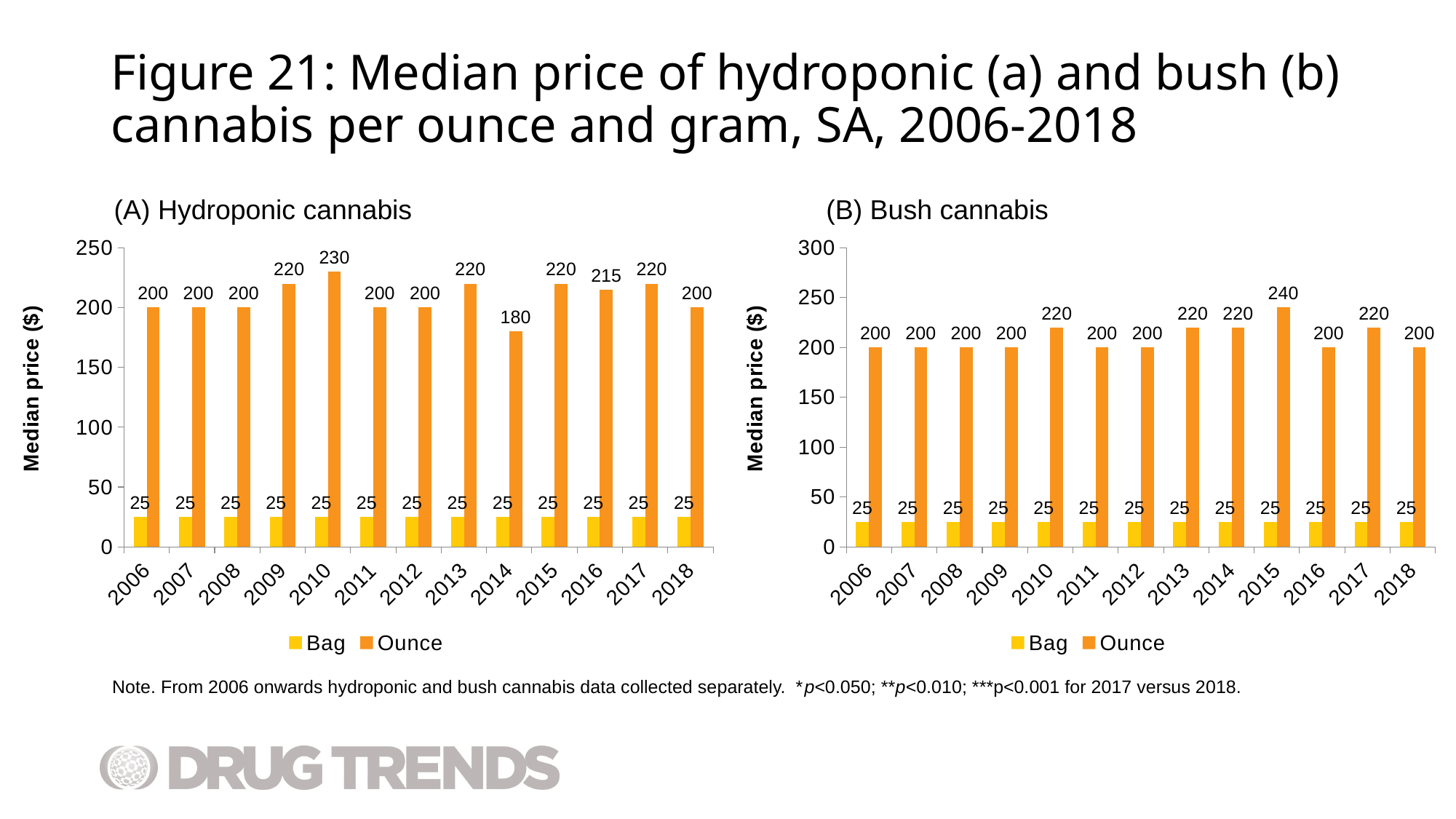
Is the ounce price in 2016 higher in the Hydroponic cannabis chart or the Bush cannabis chart? Hydroponic cannabis In the Hydroponic cannabis chart, what is the median price per ounce in 2014? 180 In the Hydroponic cannabis chart, what is the median price per ounce in 2010? 230 In the Bush cannabis chart, what is the median price per ounce in 2015? 240 How many years are shown on the x axis of the Bush cannabis chart? 13 In the Bush cannabis chart, what is the median price per bag in 2018? 25 In the Bush cannabis chart, what is the difference between the ounce price and the bag price in 2015? 215 How many series does the legend of the Hydroponic cannabis chart list? 2 In the Hydroponic cannabis chart, what is the difference between the ounce price in 2010 and the ounce price in 2014? 50 In the Bush cannabis chart, which year has the highest median price per ounce? 2015 In the Hydroponic cannabis chart, which year has the highest median price per ounce? 2010 In the Hydroponic cannabis chart, which year has the lowest median price per ounce? 2014